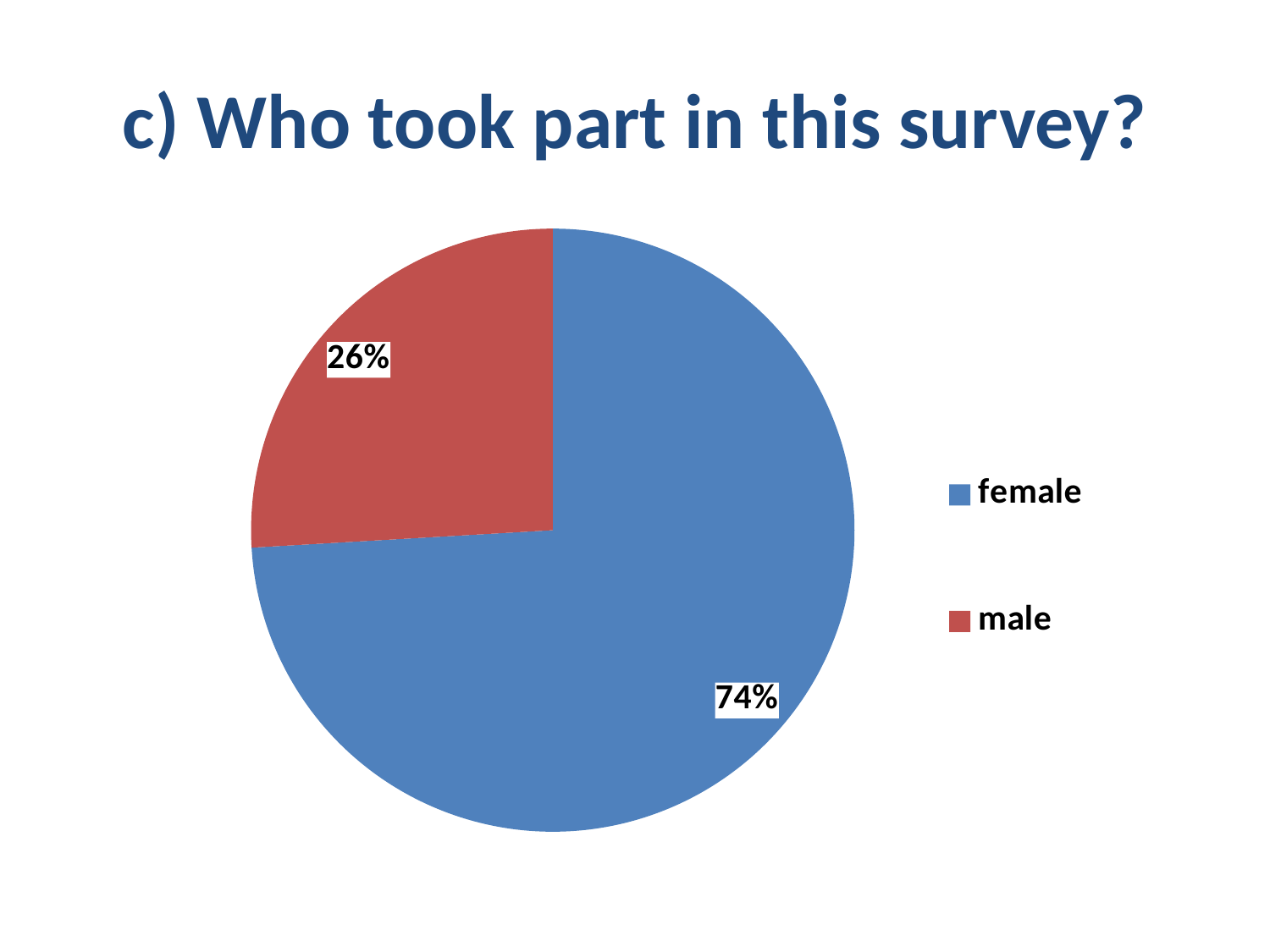
How many entries does the legend list? 2 Which category has the largest slice of the pie? female What share of the pie is female? 74% What kind of chart is shown on the slide? pie chart Which slice is larger, female or male? female How many slices does the pie chart have? 2 What share of the pie is male? 26% What is the difference in percentage points between the female and male slices? 48 What is the title of the slide? c) Who took part in this survey? What colour is the female slice? blue Which category has the smallest slice of the pie? male